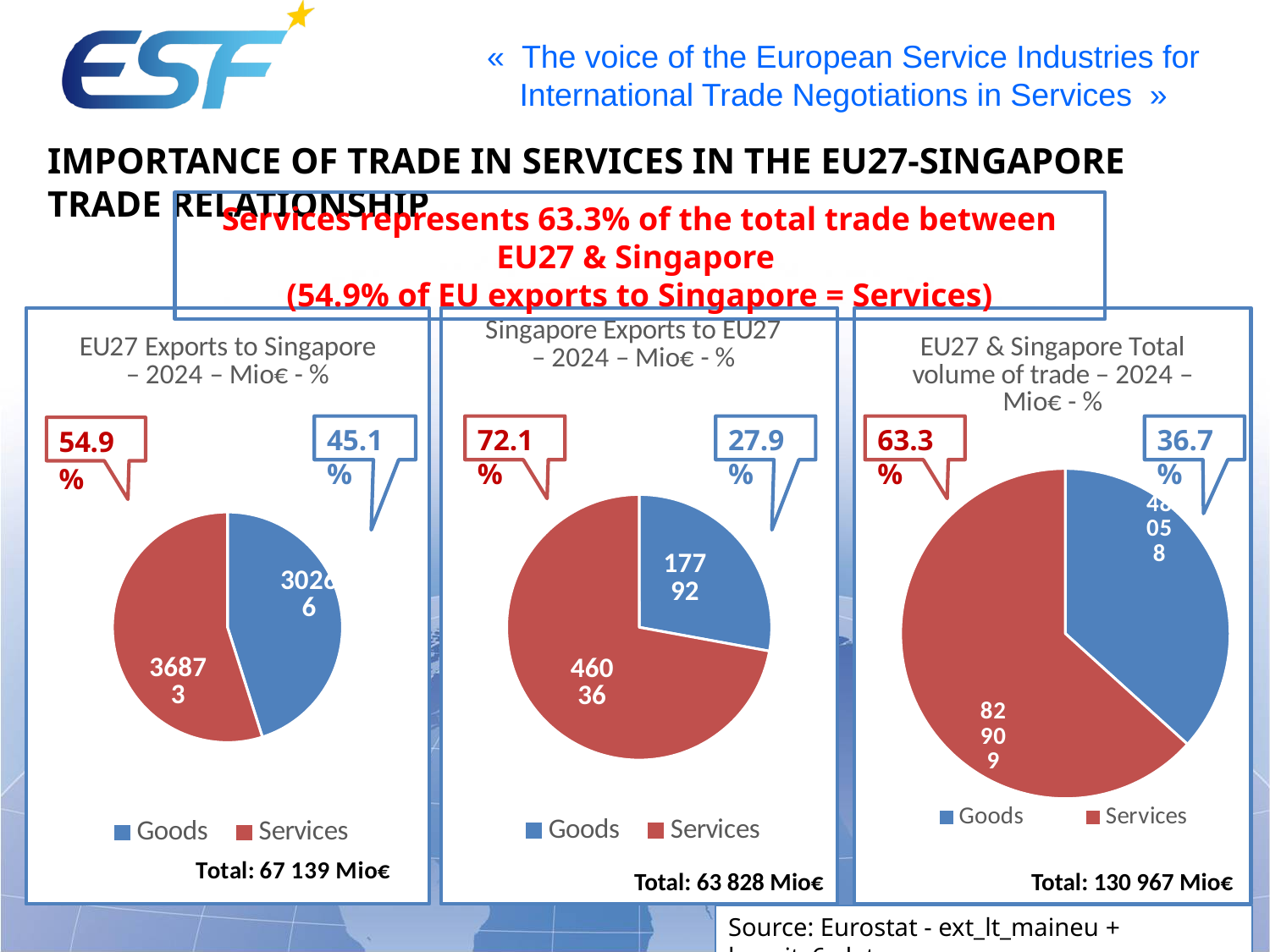
What total is printed below the 'EU27 & Singapore Total volume of trade' pie chart? Total: 130 967 Mio€ In the 'EU27 & Singapore Total volume of trade' pie chart, what share of the pie is Goods? 36.7% In the 'EU27 & Singapore Total volume of trade' pie chart, what is the value for Services? 82909 In the 'EU27 Exports to Singapore' pie chart, what share of the pie is Services? 54.9% In the 'Singapore Exports to EU27' pie chart, what is the value for Services? 46036 What kind of chart is the 'EU27 Exports to Singapore' chart? Pie chart In the 'EU27 & Singapore Total volume of trade' pie chart, which category is the largest? Services In the 'Singapore Exports to EU27' pie chart, what is the value for Goods? 17792 How many categories does the legend of the 'Singapore Exports to EU27' pie chart list? 2 In the 'Singapore Exports to EU27' pie chart, which is larger, Goods or Services? Services In the 'Singapore Exports to EU27' pie chart, what share of the pie is Services? 72.1%